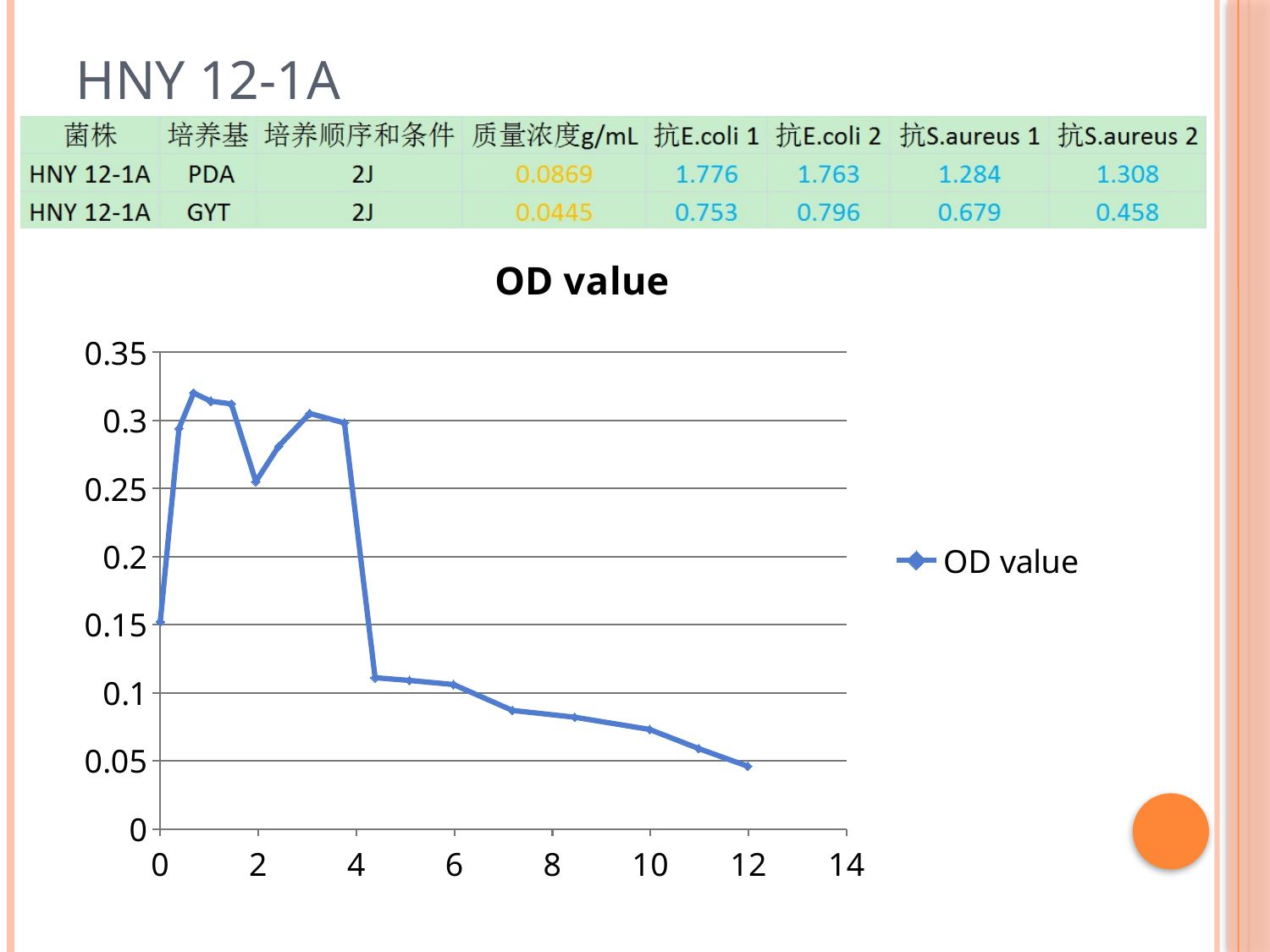
Is the OD value at x = 2 greater or less than 0.3? less Which is larger, the OD value at x = 2 or the OD value at x = 6? x = 2 What is the name of the series shown in the legend? OD value Is the OD value at x = 2 greater or less than 0.2? greater What is the title of the chart? OD value Which is larger, the OD value at x = 0 or the OD value at x = 12? x = 0 Is the highest OD value on the chart greater or less than 0.3? greater Do the OD values generally rise or fall along the x axis from x = 4 to x = 12? fall How many series does the chart legend list? 1 What kind of chart is shown on the slide? line chart